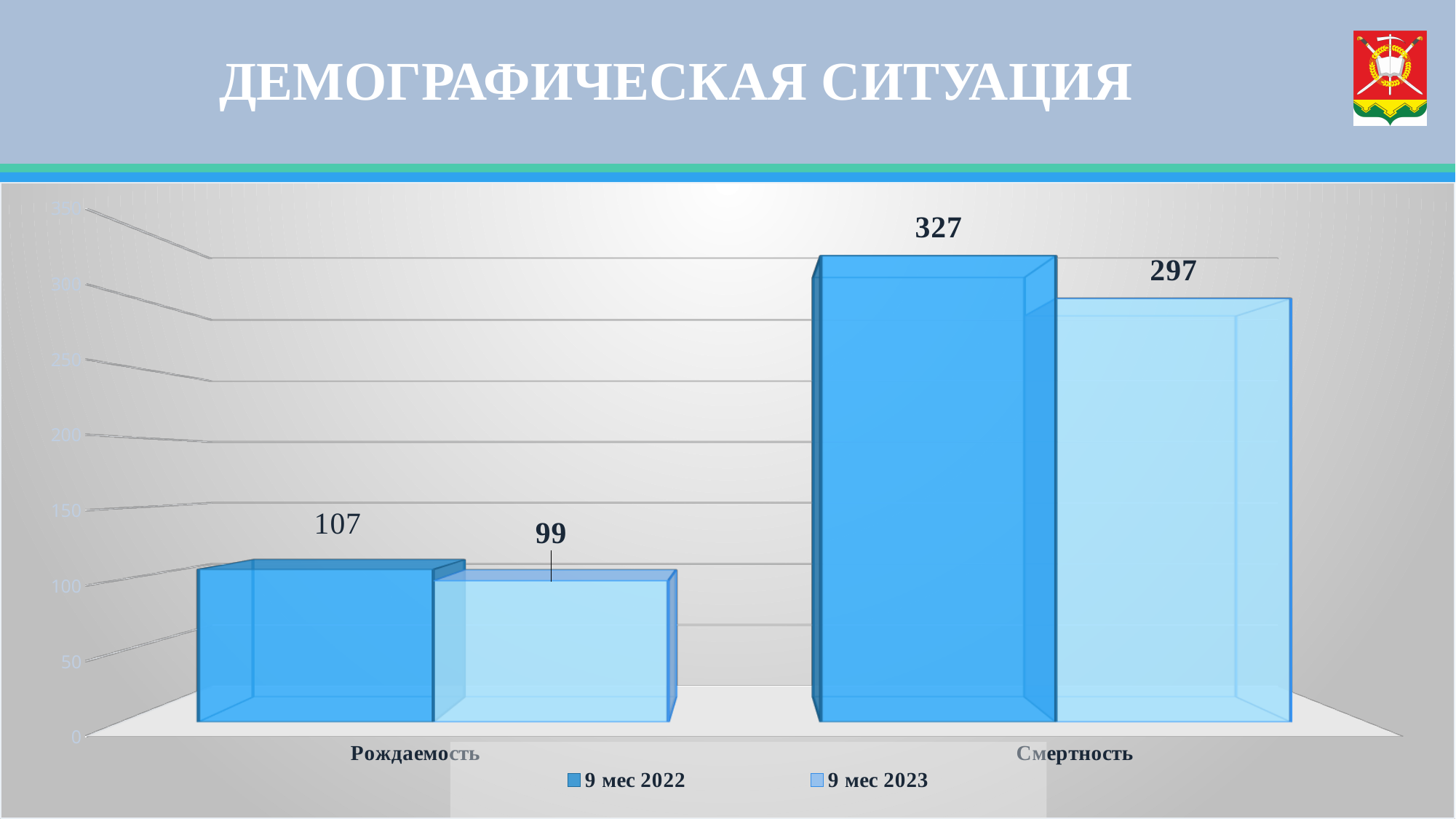
What is the value for Рождаемость in the 9 мес 2022 series? 107 How many series does the legend list? 2 Which category has the lowest value in the 9 мес 2023 series? Рождаемость What is the difference between the 9 мес 2022 and 9 мес 2023 values for Смертность? 30 What is the value for Смертность in the 9 мес 2022 series? 327 What kind of chart is shown on the slide? Bar chart Which is larger for Рождаемость: the 9 мес 2022 value or the 9 мес 2023 value? 9 мес 2022 How many categories are shown on the x axis? 2 What is the value for Смертность in the 9 мес 2023 series? 297 What is the difference between the 9 мес 2022 and 9 мес 2023 values for Рождаемость? 8 Which category has the highest value in the 9 мес 2022 series? Смертность What is the value for Рождаемость in the 9 мес 2023 series? 99